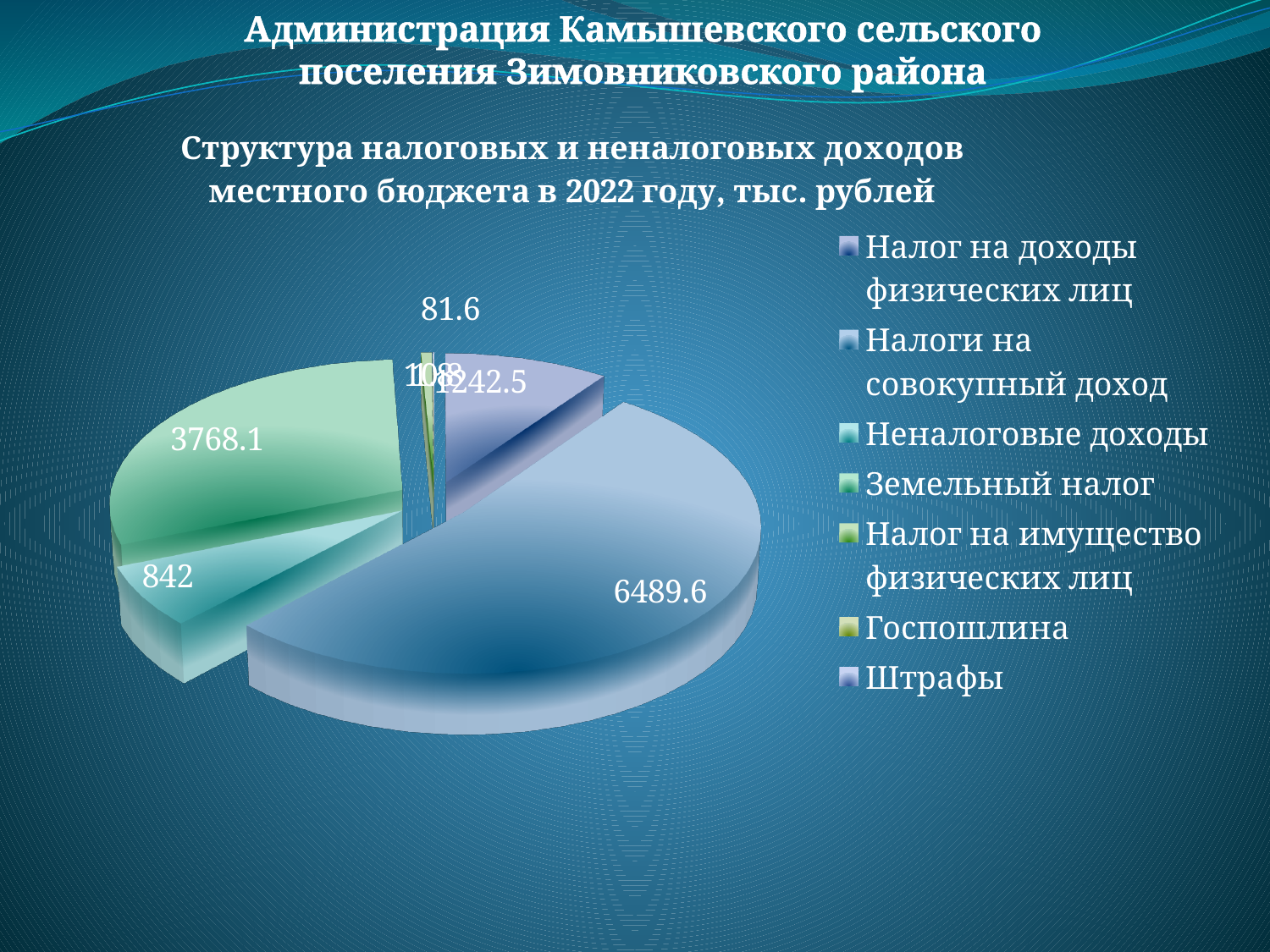
Which is larger, the slice labeled 3768.1 or the slice labeled 1242.5? 3768.1 How many entries does the legend of the pie chart list? 7 What type of chart is shown on the slide? pie chart What is the largest value labeled on the pie chart? 6489.6 How many slices does the pie chart have? 7 What is the value labeled on the teal slice at the lower left of the pie? 842 What is the value labeled on the large green slice on the left of the pie? 3768.1 What is the title of the chart? Структура налоговых и неналоговых доходов местного бюджета в 2022 году, тыс. рублей Which entry is listed first in the chart legend? Налог на доходы физических лиц What is the difference between the slice labeled 1242.5 and the slice labeled 81.6? 1160.9 What is the difference between the slice labeled 3768.1 and the slice labeled 842? 2926.1 What is the difference between the slice labeled 6489.6 and the slice labeled 3768.1? 2721.5